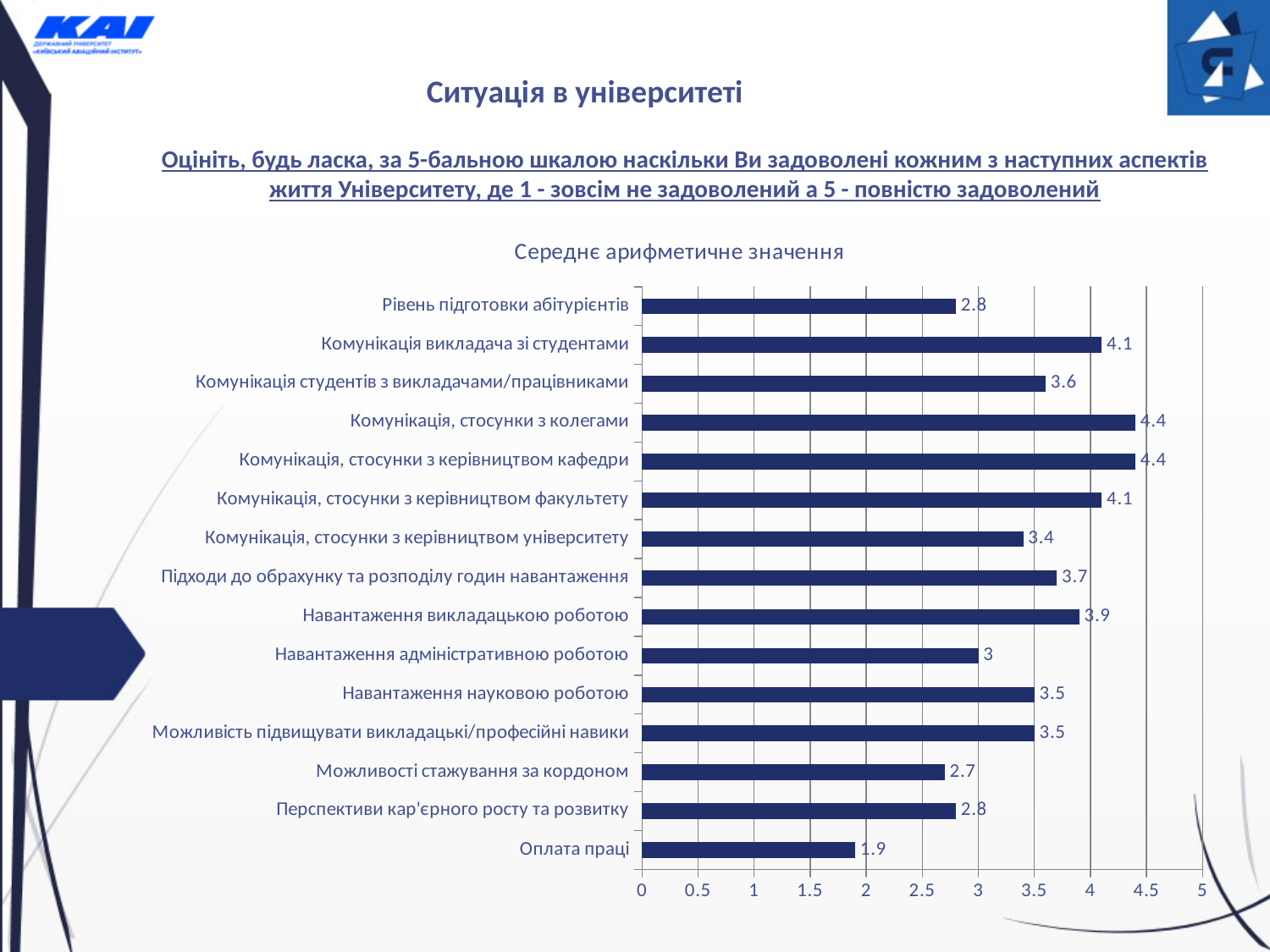
What is the difference between the values for Комунікація, стосунки з колегами and Оплата праці? 2.5 What is the difference between the values for Навантаження викладацькою роботою and Навантаження адміністративною роботою? 0.9 How many categories are shown in the chart? 15 Is the value for Підходи до обрахунку та розподілу годин навантаження greater or less than 3.5? greater What is the value for Навантаження адміністративною роботою? 3 What kind of chart is shown on the slide? bar chart What is the value for Оплата праці? 1.9 Which category has the lowest value? Оплата праці What is the value for Можливості стажування за кордоном? 2.7 What is the title of the chart? Середнє арифметичне значення What is the value for Комунікація, стосунки з керівництвом університету? 3.4 Which is larger: the value for Комунікація викладача зі студентами or the value for Комунікація студентів з викладачами/працівниками? Комунікація викладача зі студентами